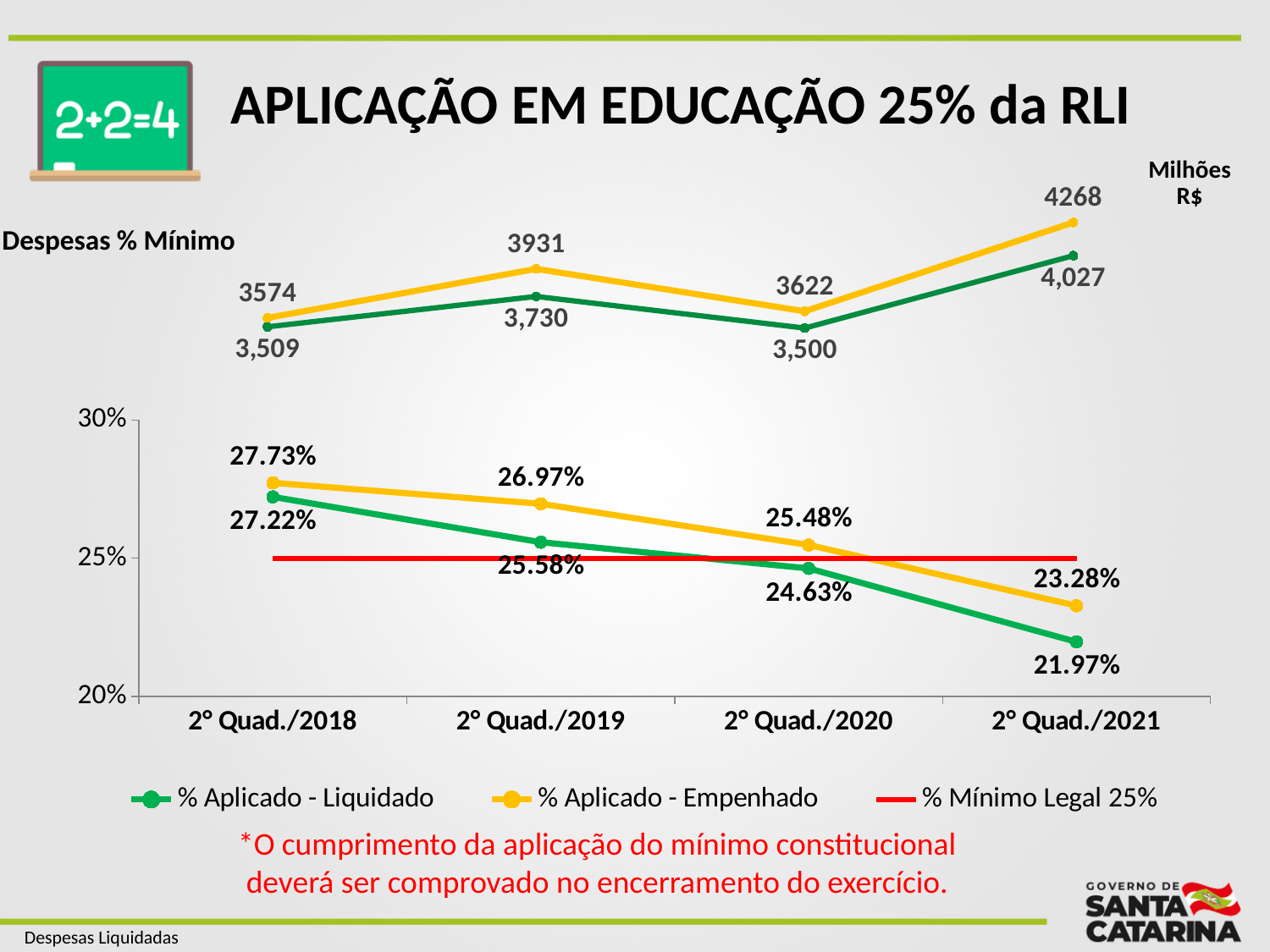
In the lower chart, what is the difference between % Aplicado - Empenhado and % Aplicado - Liquidado for 2° Quad./2020? 0.85% How many quadrimesters are shown on the x axis of the lower chart? 4 In the lower chart, which quadrimester has the lowest % Aplicado - Liquidado value? 2° Quad./2021 In the lower chart, does the % Aplicado - Liquidado series rise or fall from 2° Quad./2018 to 2° Quad./2021? fall How many series does the legend of the lower chart list? 3 In the lower chart, which quadrimester has the highest % Aplicado - Empenhado value? 2° Quad./2018 In the lower chart, what is the value of % Aplicado - Liquidado for 2° Quad./2021? 21.97% In the upper chart (Milhões R$), what is the value of the green line for 2° Quad./2020? 3,500 In the lower chart, is the % Aplicado - Liquidado value for 2° Quad./2020 greater or less than 25%? less In the upper chart (Milhões R$), what is the value of the yellow line for 2° Quad./2021? 4268 What kind of chart is the lower chart? line chart In the lower chart, what is the value of % Aplicado - Empenhado for 2° Quad./2019? 26.97%